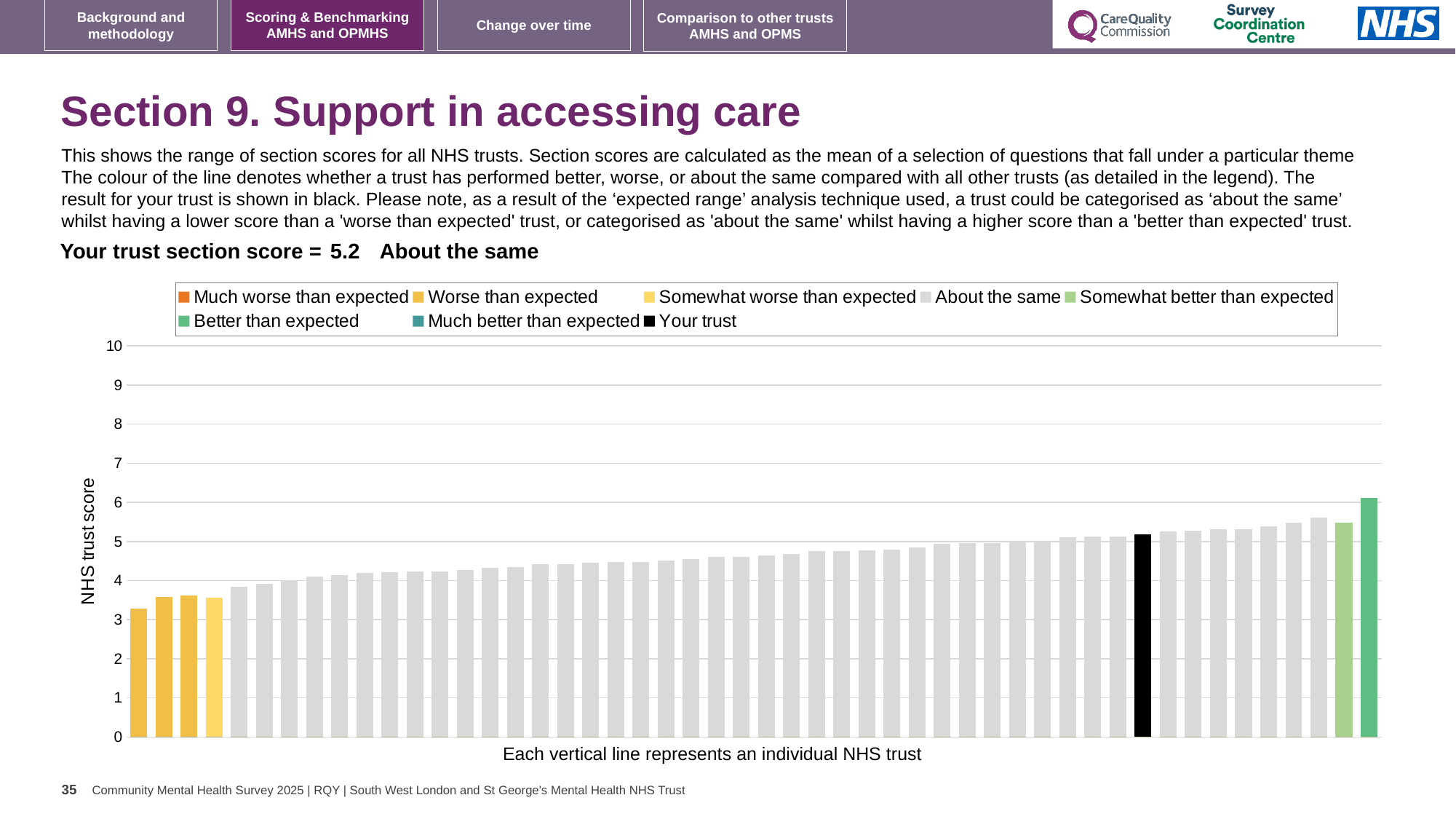
How many entries does the legend list? 8 What kind of chart is shown on the slide? bar chart Is the value for your trust (the black bar) greater or less than 5? greater How is your trust's section score categorised compared with other trusts? About the same What is the label on the y axis? NHS trust score Is the value of the lowest bar greater or less than 4? less Which is larger: the value for your trust (black bar) or the value of the leftmost bar? your trust What is the highest value shown on the y axis? 10 What colour is the bar representing your trust? black What is the section score for your trust? 5.2 Is the value of the highest bar greater or less than 5? greater Do the bar values rise or fall from left to right along the x axis? rise